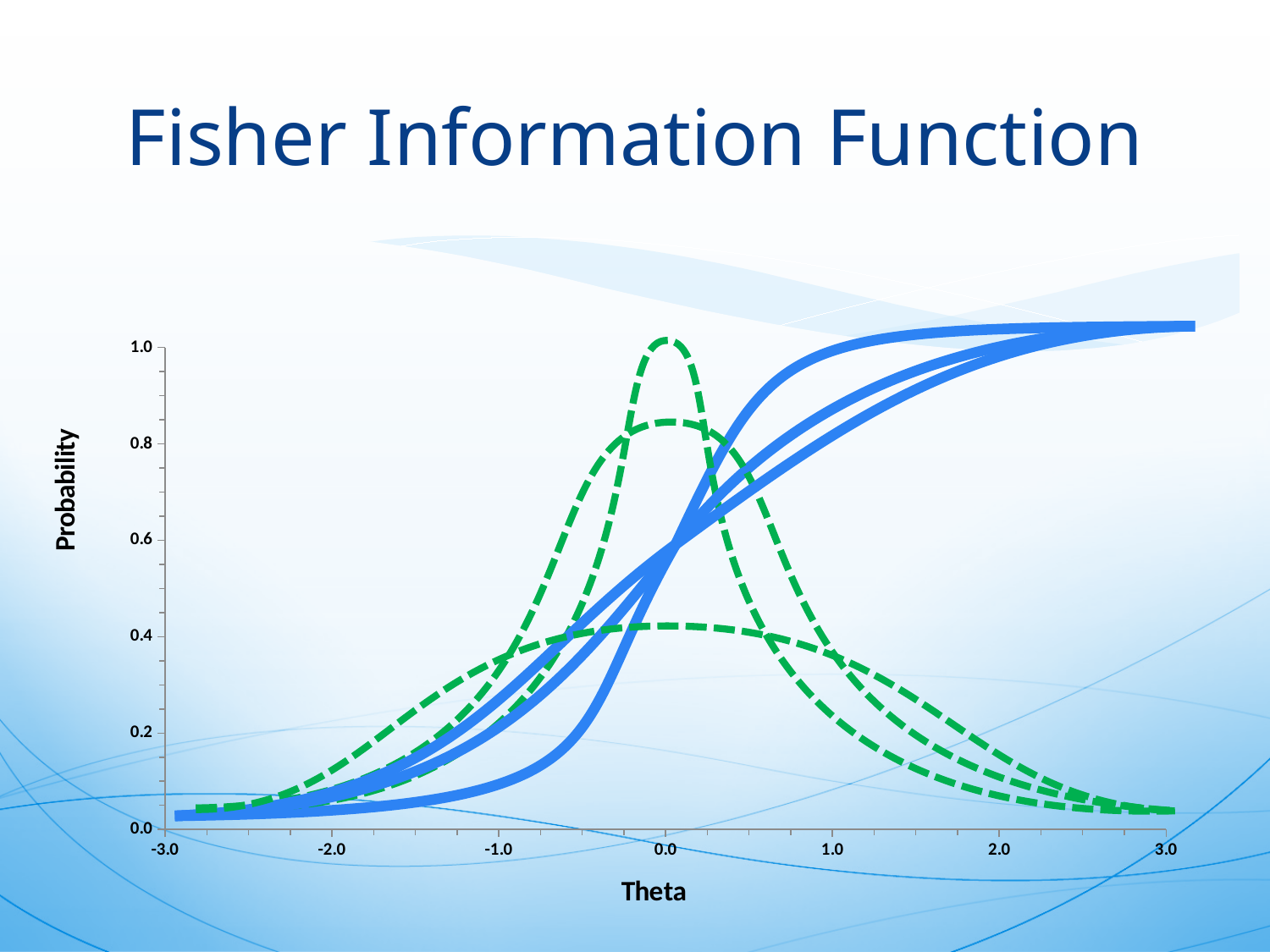
Is the peak value of the tallest dashed green curve greater or less than 0.8? greater Is the value of the solid blue curves at Theta = 3.0 greater or less than 0.8? greater What kind of chart is shown on the slide? line chart Is the value of the solid blue curves at Theta = -3.0 greater or less than 0.2? less At which Theta value do the dashed green curves reach their peak? 0.0 Do the solid blue curves rise or fall as Theta increases from -3.0 to 3.0? rise What is the title of the chart on the slide? Fisher Information Function What is the label of the x axis? Theta How many solid blue curves are plotted on the chart? 3 What is the highest tick value shown on the Probability axis? 1.0 How many dashed green curves are plotted on the chart? 3